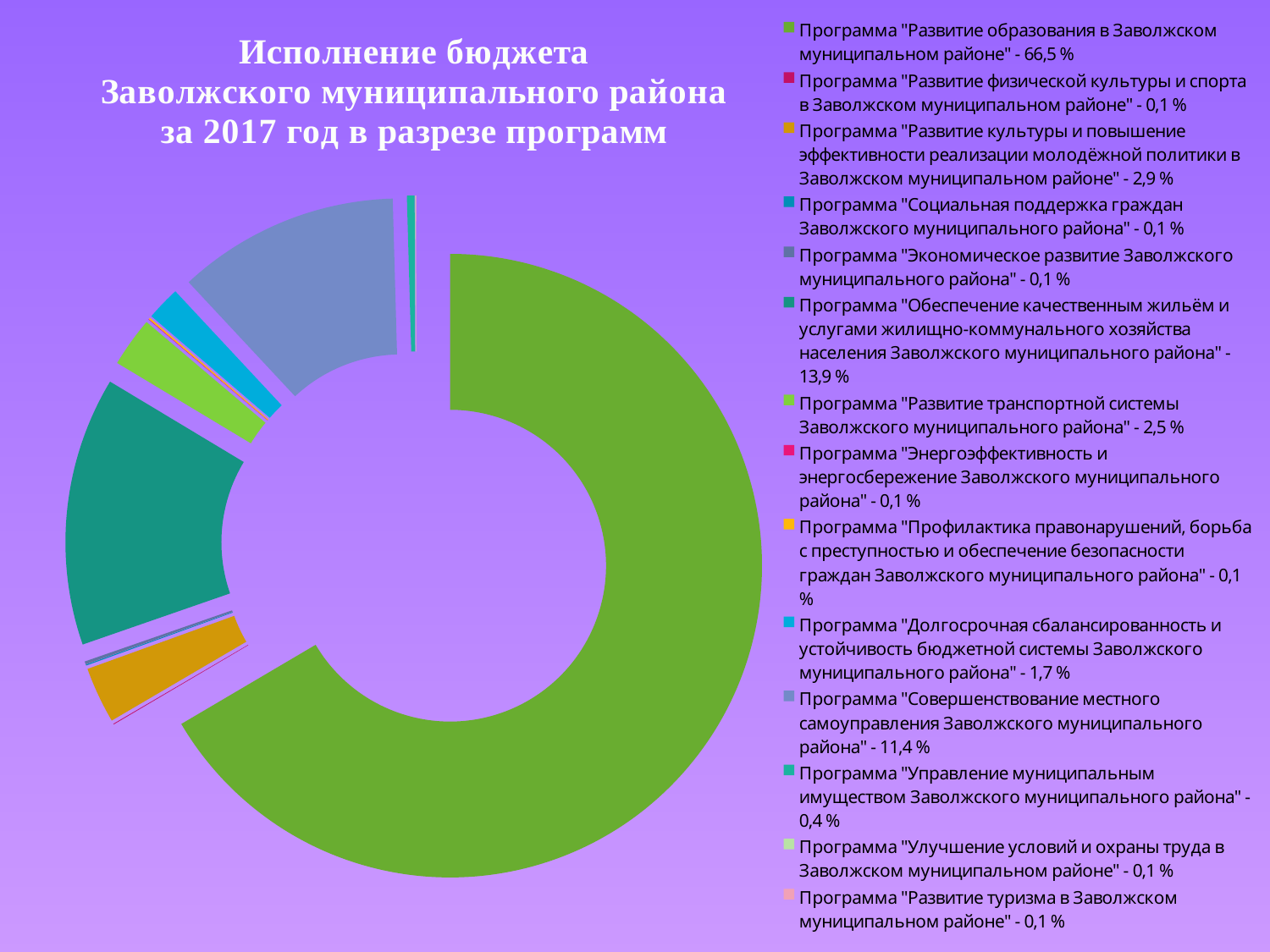
How many programmes are listed in the legend? 14 What type of chart is shown on the slide? Doughnut (pie) chart What share of the budget went to the programme "Развитие образования в Заволжском муниципальном районе"? 66,5 % What is the difference in share between the programme "Развитие образования" (66,5 %) and the programme "Обеспечение качественным жильём и услугами ЖКХ" (13,9 %)? 52,6 % For which year does the chart show the budget execution of the Заволжский municipal district? 2017 What share of the budget went to the programme "Управление муниципальным имуществом Заволжского муниципального района"? 0,4 % What share of the budget went to the programme "Совершенствование местного самоуправления Заволжского муниципального района"? 11,4 % What share of the budget went to the programme "Долгосрочная сбалансированность и устойчивость бюджетной системы Заволжского муниципального района"? 1,7 % Which programme has the largest share of the budget? Программа "Развитие образования в Заволжском муниципальном районе" What share of the budget went to the programme "Обеспечение качественным жильём и услугами жилищно-коммунального хозяйства населения Заволжского муниципального района"? 13,9 % Which has the larger share: the programme "Развитие культуры и повышение эффективности реализации молодёжной политики" or the programme "Развитие транспортной системы"? Программа "Развитие культуры и повышение эффективности реализации молодёжной политики" (2,9 %) What is the difference in share between the programme "Обеспечение качественным жильём и услугами ЖКХ" (13,9 %) and the programme "Совершенствование местного самоуправления" (11,4 %)? 2,5 %